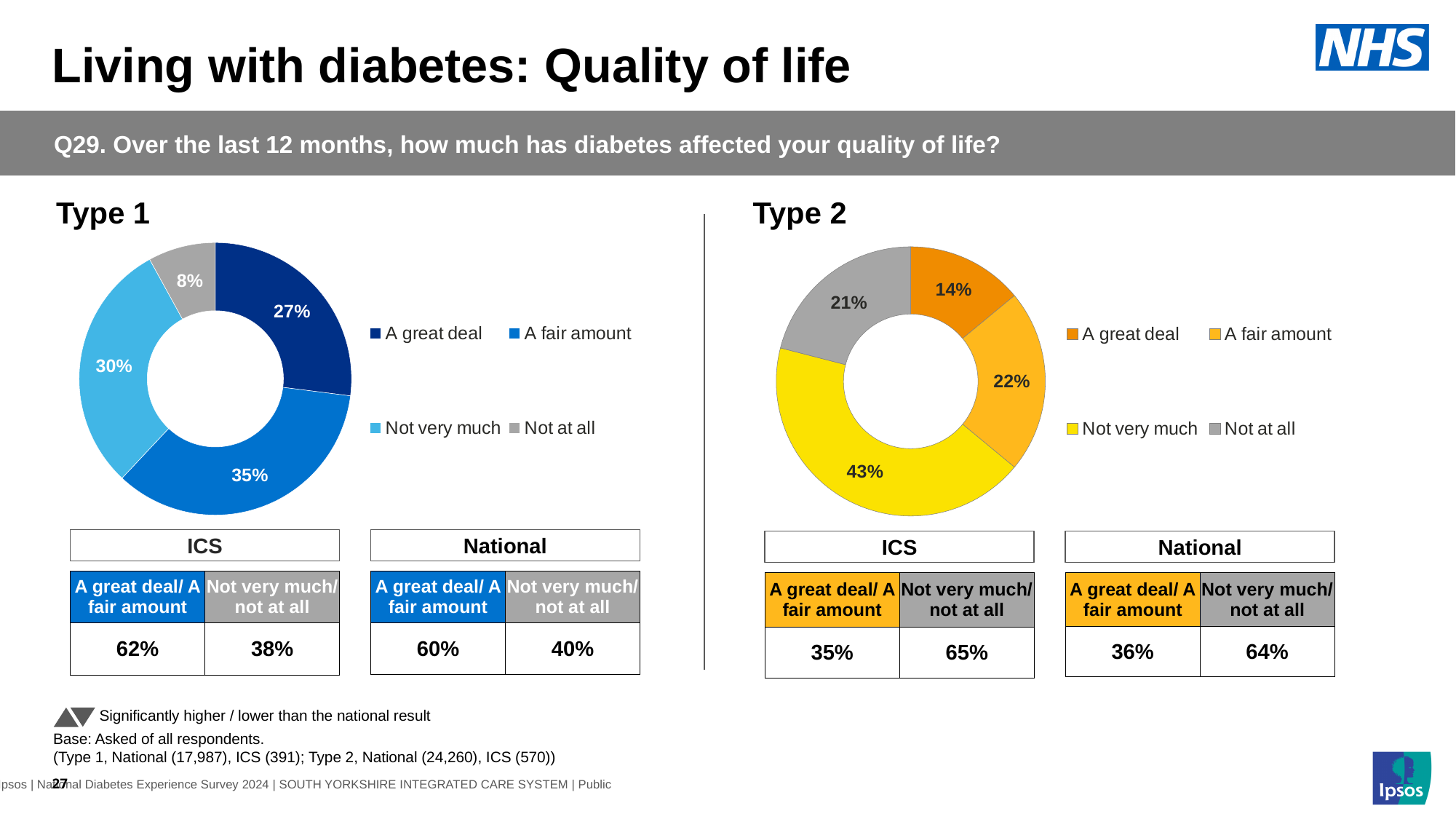
In the Type 2 chart, what percentage said 'A fair amount'? 22% In the Type 1 chart, what colour represents 'Not very much'? Light blue In the Type 2 chart, what is the combined share of 'Not very much' and 'Not at all'? 64% In the Type 1 chart, what is the difference between the 'A fair amount' and 'Not at all' shares? 27 percentage points In the Type 2 chart, which category has the largest share? Not very much In the Type 1 chart, which category has the smallest share? Not at all In the Type 1 chart, what is the combined share of 'A great deal' and 'A fair amount'? 62% In the Type 1 chart, what percentage of respondents said diabetes affected their quality of life 'A great deal'? 27% In the Type 2 chart, what percentage of respondents said 'Not very much'? 43% In the Type 2 chart, which is larger: 'A great deal' or 'Not at all'? Not at all What kind of chart is used for Type 2? Doughnut (pie) chart How many categories does the Type 1 chart show? 4